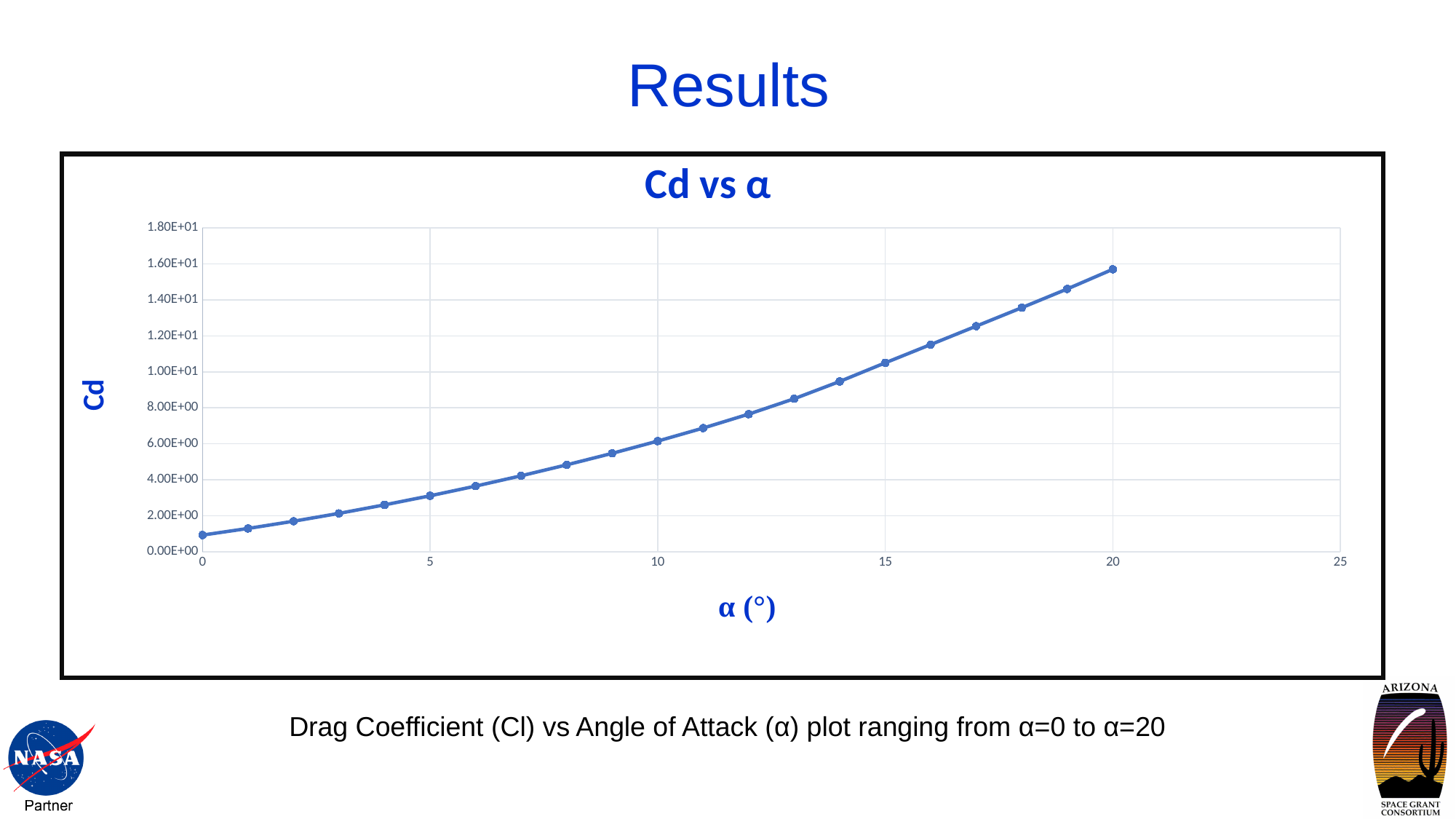
Is the value of Cd at α=0 greater or less than 2.00E+00? less Is the value of Cd at α=20 greater or less than 1.40E+01? greater Is the value of Cd at α=5 greater or less than 2.00E+00? greater Which has the larger Cd value: α=15 or α=5? α=15 At which value of α is Cd lowest? 0 At which value of α is Cd highest? 20 What is the title of the chart? Cd vs α What is the label of the x axis of the chart? α (°) How many data points are plotted on the Cd vs α chart? 21 What kind of chart is shown on the slide? line chart Does Cd rise or fall as α increases from 0 to 20? rises